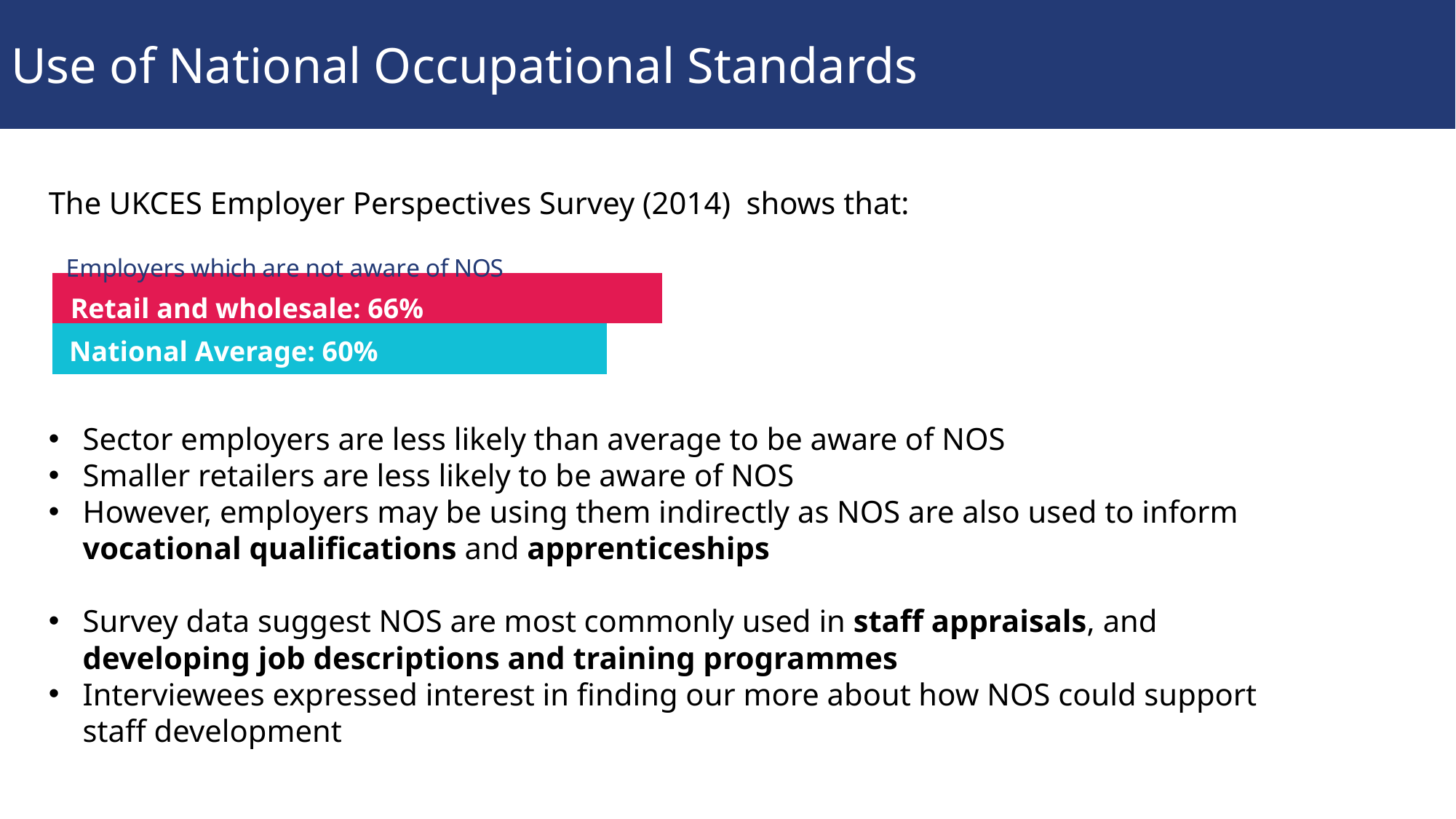
Which bar is longer: Retail and wholesale or National Average? Retail and wholesale How many bars are shown in the chart? 2 What colour is the Retail and wholesale bar? red What percentage of retail and wholesale employers are not aware of NOS? 66% What is the difference between the Retail and wholesale value and the National Average value? 6% Which category has the lower value in the chart? National Average What is the national average percentage of employers not aware of NOS? 60% Is the value for Retail and wholesale larger or smaller than the National Average? larger What kind of chart is shown on the slide? bar chart What is the title of the chart? Employers which are not aware of NOS